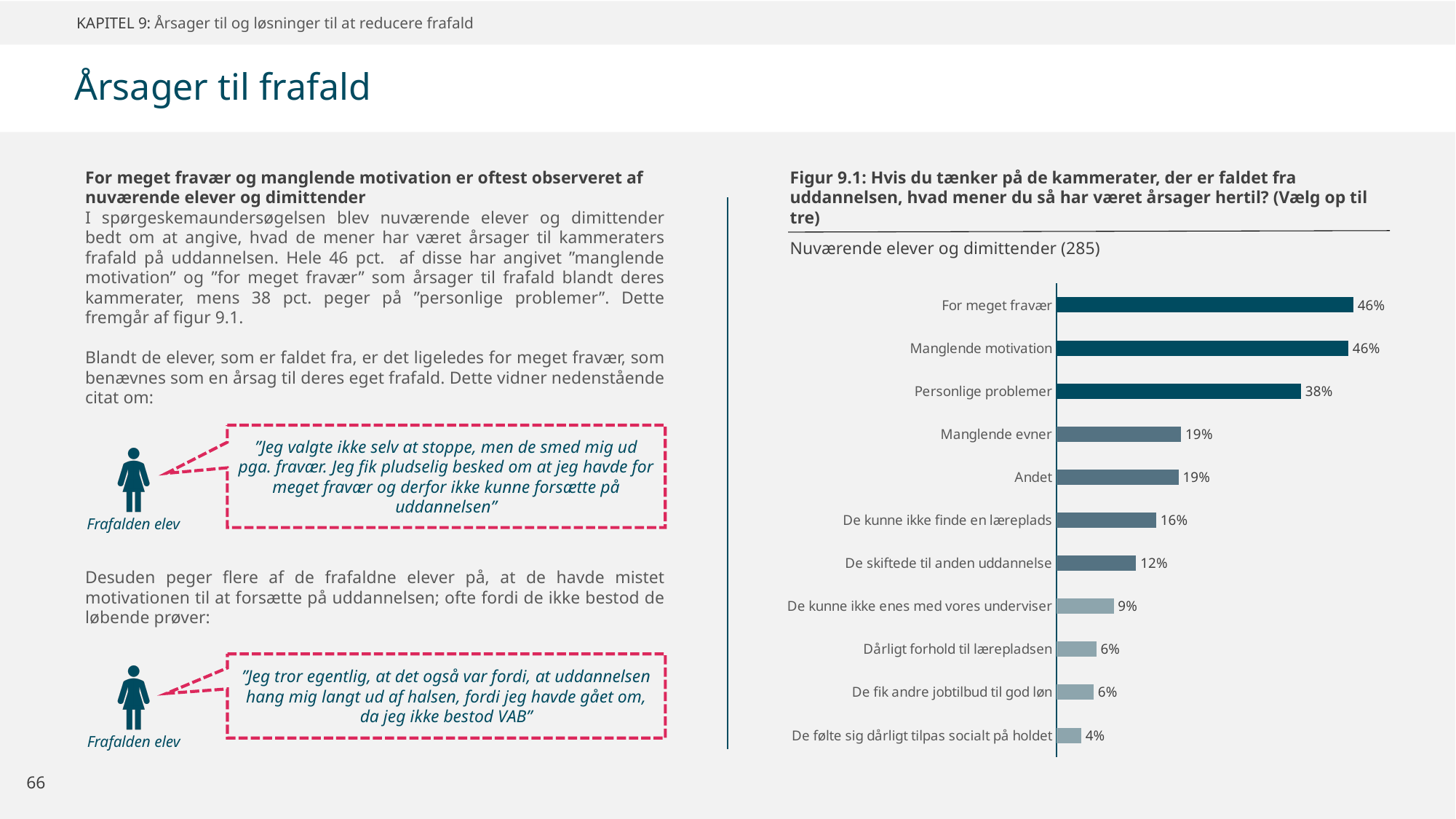
What is the value for "De kunne ikke enes med vores underviser"? 9% What is the value for "De kunne ikke finde en læreplads"? 16% Which is larger, the value for "Andet" or the value for "De skiftede til anden uddannelse"? Andet What is the difference between the values for "Manglende motivation" and "Personlige problemer"? 8% What kind of chart is shown in Figur 9.1? Bar chart What is the difference between the values for "Manglende evner" and "Dårligt forhold til lærepladsen"? 13% How many categories are shown in the chart? 11 Do the values rise or fall going from the top bar to the bottom bar? Fall Which category has the lowest value? De følte sig dårligt tilpas socialt på holdet What is the value for "Personlige problemer"? 38% What is the subtitle shown above the bars, indicating the respondent group and sample size? Nuværende elever og dimittender (285) What is the value for "De skiftede til anden uddannelse"? 12%